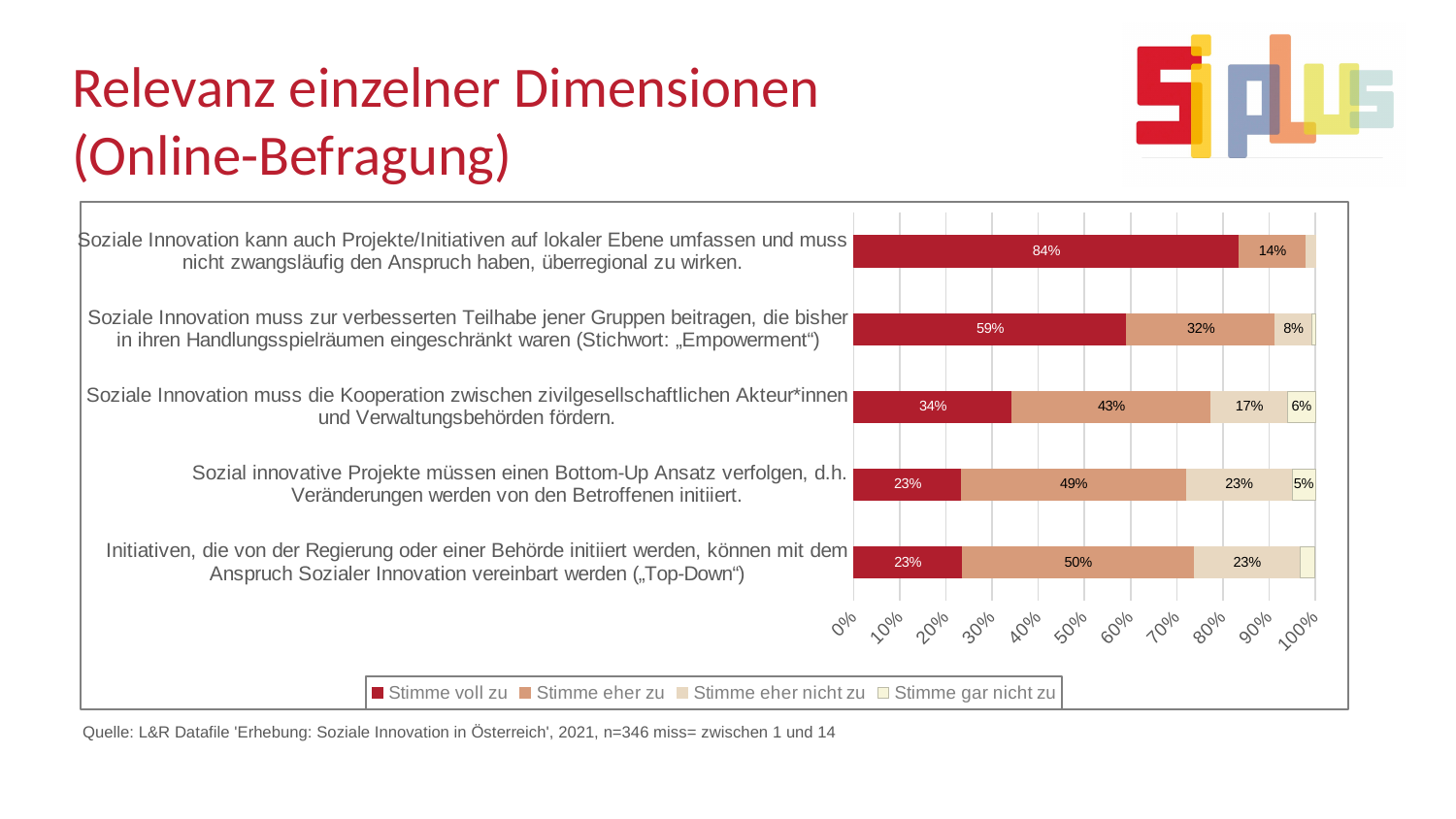
What is the 'Stimme voll zu' value for the statement that Soziale Innovation kann auch Projekte/Initiativen auf lokaler Ebene umfassen? 84% How many series does the legend list? 4 Which statement has the highest 'Stimme voll zu' value? Soziale Innovation kann auch Projekte/Initiativen auf lokaler Ebene umfassen und muss nicht zwangsläufig den Anspruch haben, überregional zu wirken. Which is larger: the 'Stimme eher zu' value for the Bottom-Up statement or for the Kooperation statement? Bottom-Up statement What kind of chart is shown on the slide? stacked bar chart Which statement has the lowest 'Stimme eher zu' value? Soziale Innovation kann auch Projekte/Initiativen auf lokaler Ebene umfassen und muss nicht zwangsläufig den Anspruch haben, überregional zu wirken. What is the 'Stimme eher zu' value for the statement about Empowerment (verbesserte Teilhabe)? 32% What is the 'Stimme gar nicht zu' value for the statement that Soziale Innovation die Kooperation zwischen zivilgesellschaftlichen Akteur*innen und Verwaltungsbehörden fördern muss? 6% What is the 'Stimme eher zu' value for the statement about Top-Down initiatives? 50% How many statements (categories) are plotted in the chart? 5 What is the difference between the 'Stimme voll zu' values for the lokale Ebene statement (84%) and the Empowerment statement (59%)? 25% Which legend entry is shown in dark red? Stimme voll zu